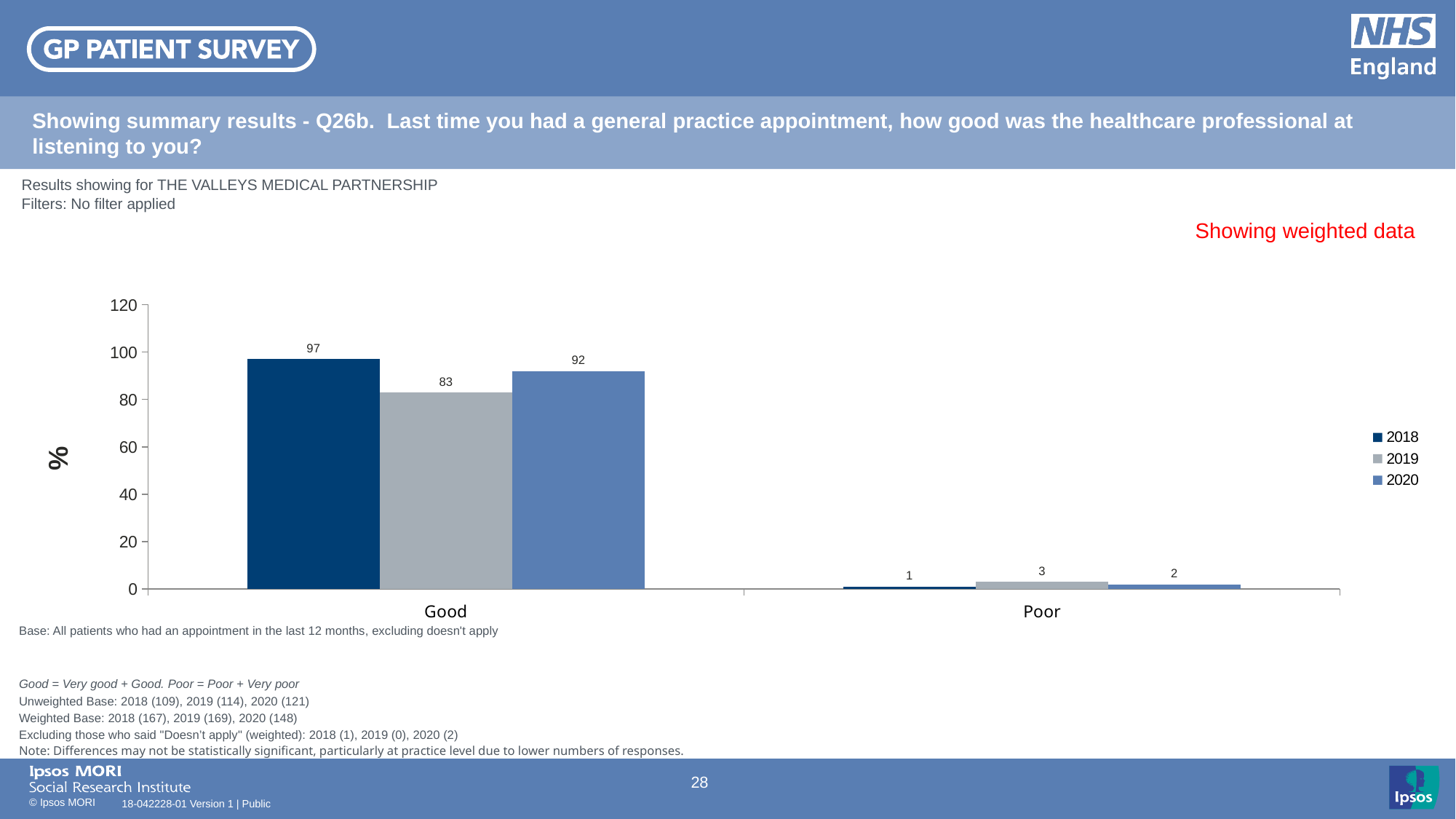
What is the difference between the 2018 and 2019 values in the Good category? 14 How many series does the legend list? 3 What kind of chart is shown on the slide? bar chart What is the value for 2020 in the Poor category? 2 How many categories are shown on the x axis? 2 What is the value for 2019 in the Good category? 83 Is the value for 2019 in the Good category greater or less than 100? less Which year has the lowest value in the Poor category? 2018 What is the value for 2018 in the Good category? 97 Which is larger in the Good category: the 2019 value or the 2020 value? 2020 What is the label on the y axis? % Which year has the highest value in the Good category? 2018